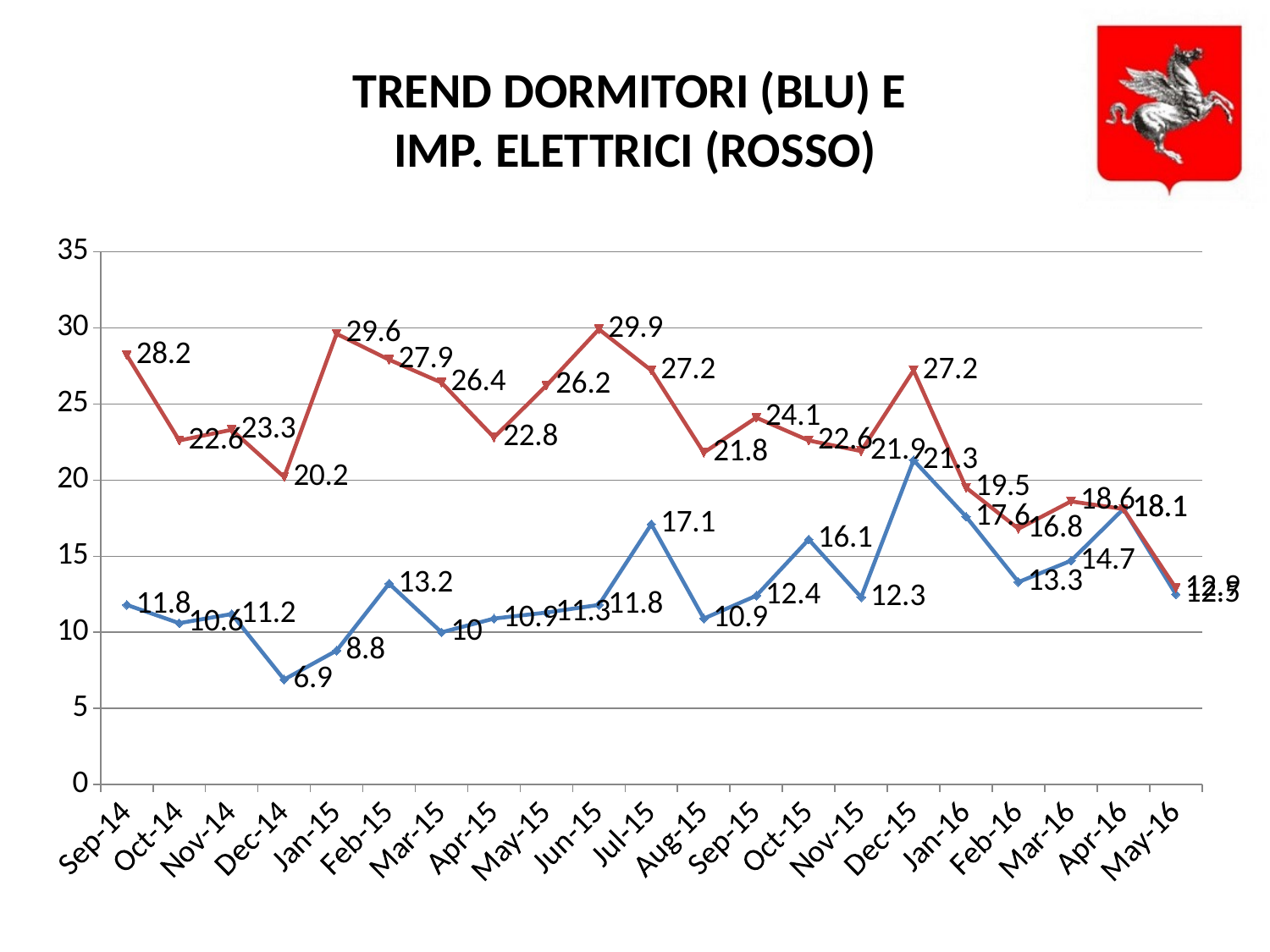
What is the difference between the red and blue values in Jan-15? 20.8 What is the value of the red line (imp. elettrici) for Sep-14? 28.2 In which month does the blue line (dormitori) reach its highest value? Dec-15 In which month does the red line (imp. elettrici) reach its highest value? Jun-15 Is the value of the red line for Feb-16 greater or less than 20? less Overall, does the red line (imp. elettrici) rise or fall from Sep-14 to May-16? Fall What is the value of the red line for Dec-15? 27.2 In which month does the blue line (dormitori) reach its lowest value? Dec-14 What kind of chart is shown on the slide? Line chart For the blue line, which is larger: the value for Jul-15 or the value for Oct-15? Jul-15 How many months are plotted on the x axis? 21 What is the value of the blue line (dormitori) for Dec-14? 6.9